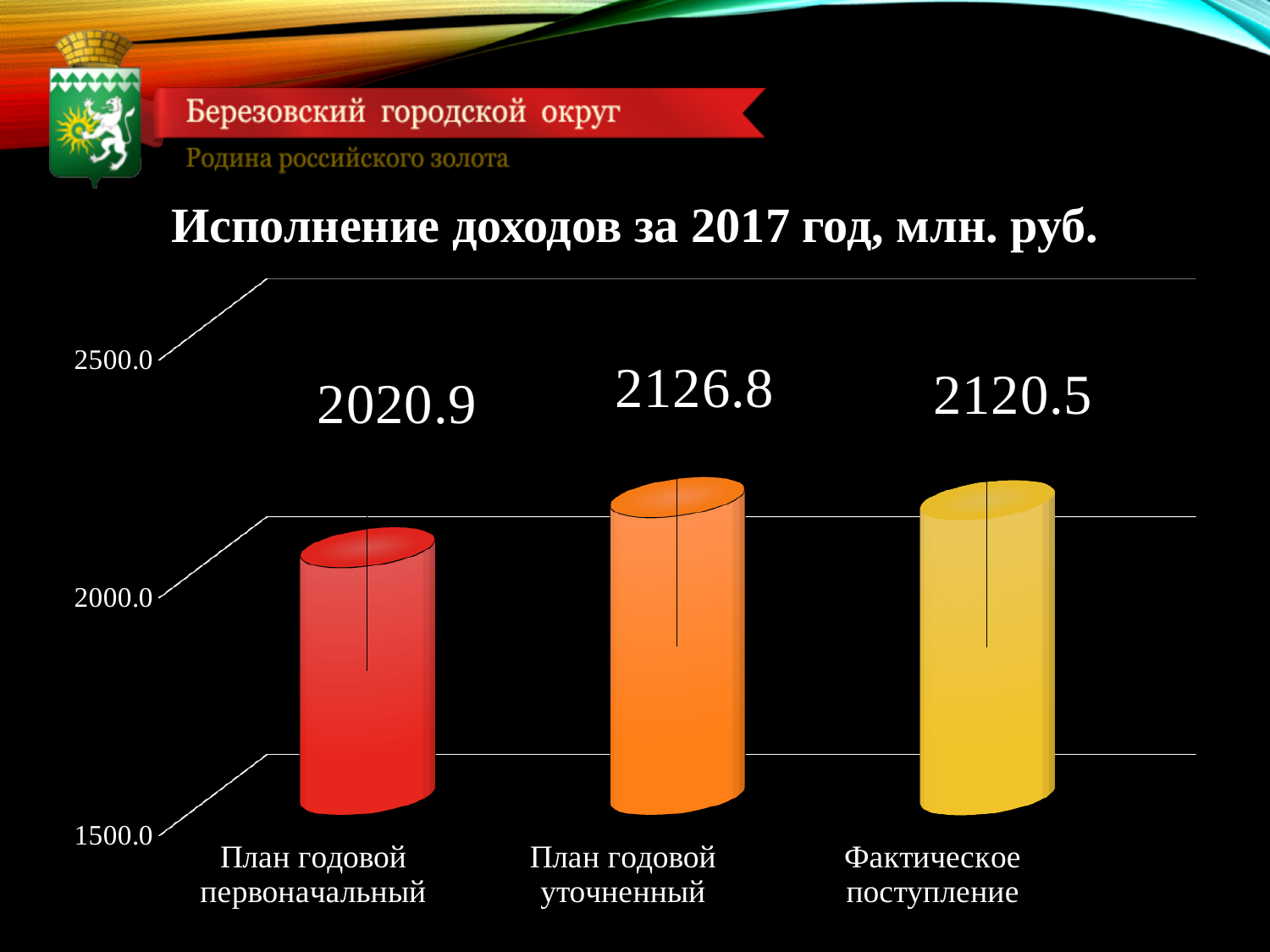
Which is larger, Фактическое поступление or План годовой первоначальный? Фактическое поступление Is the value for План годовой первоначальный greater or less than 2000.0? greater What kind of chart is shown on the slide? bar chart What is the difference between План годовой уточненный and Фактическое поступление? 6.3 What is the value for Фактическое поступление? 2120.5 Which category has the lowest value? План годовой первоначальный What is the value for План годовой первоначальный? 2020.9 Which category has the highest value? План годовой уточненный What is the difference between План годовой уточненный and План годовой первоначальный? 105.9 What is the title of the chart? Исполнение доходов за 2017 год, млн. руб. How many categories are shown in the chart? 3 What is the value for План годовой уточненный? 2126.8